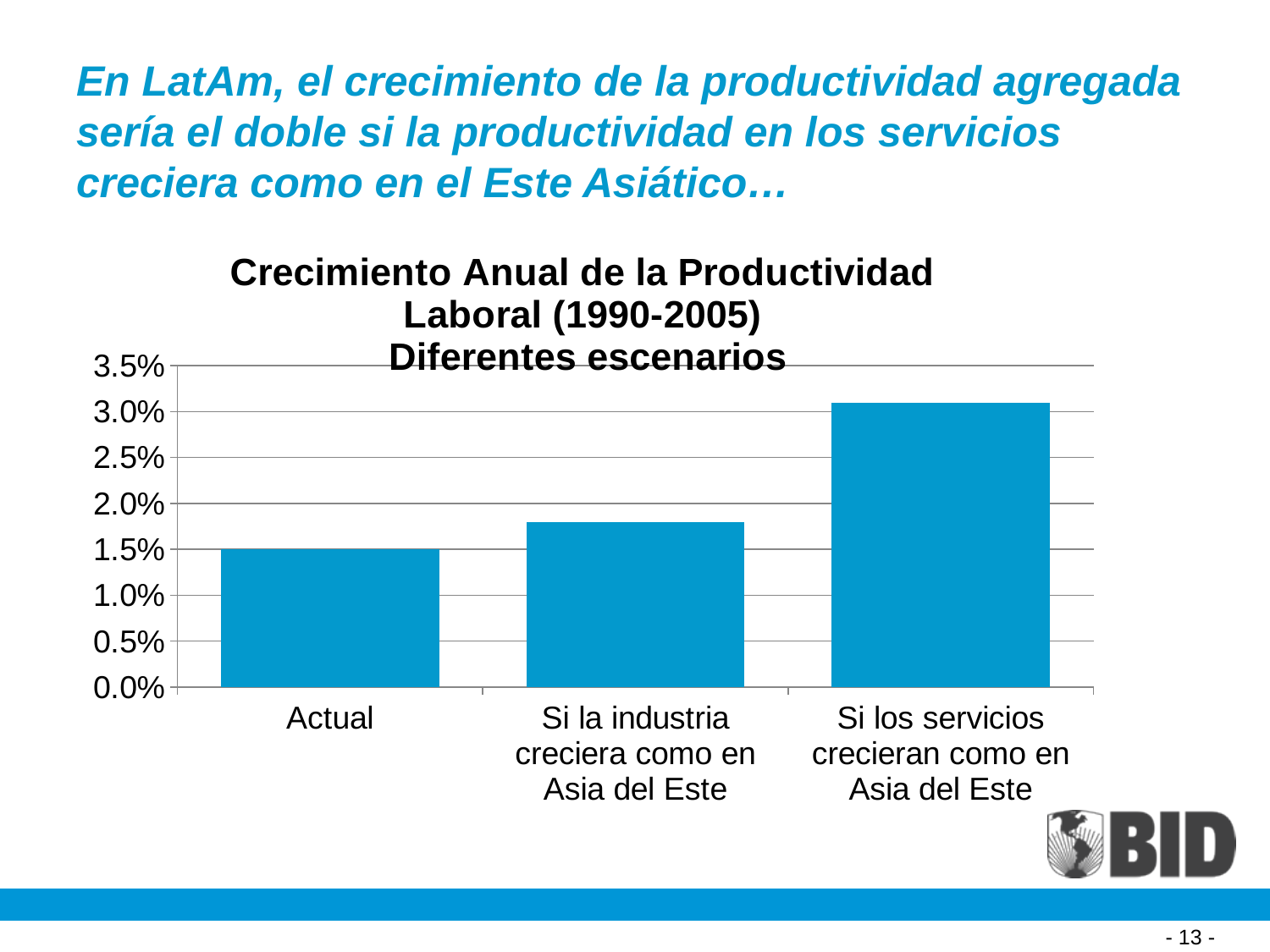
Is the value for 'Si la industria creciera como en Asia del Este' greater or less than 2.0%? less Is the value for 'Si los servicios crecieran como en Asia del Este' greater or less than 3.0%? greater Which scenario has the lowest annual labor productivity growth? Actual What kind of chart is shown on the slide? bar chart Is the value for 'Si los servicios crecieran como en Asia del Este' greater or less than 3.5%? less What is the annual labor productivity growth for the 'Actual' scenario? 1.5% Which scenario has the highest annual labor productivity growth? Si los servicios crecieran como en Asia del Este How many scenarios (bars) are plotted in the chart? 3 What period is covered by the chart according to its title? 1990-2005 Which is larger: the value for 'Si la industria creciera como en Asia del Este' or the value for 'Si los servicios crecieran como en Asia del Este'? Si los servicios crecieran como en Asia del Este Do the bar values rise or fall from left to right across the scenarios? rise